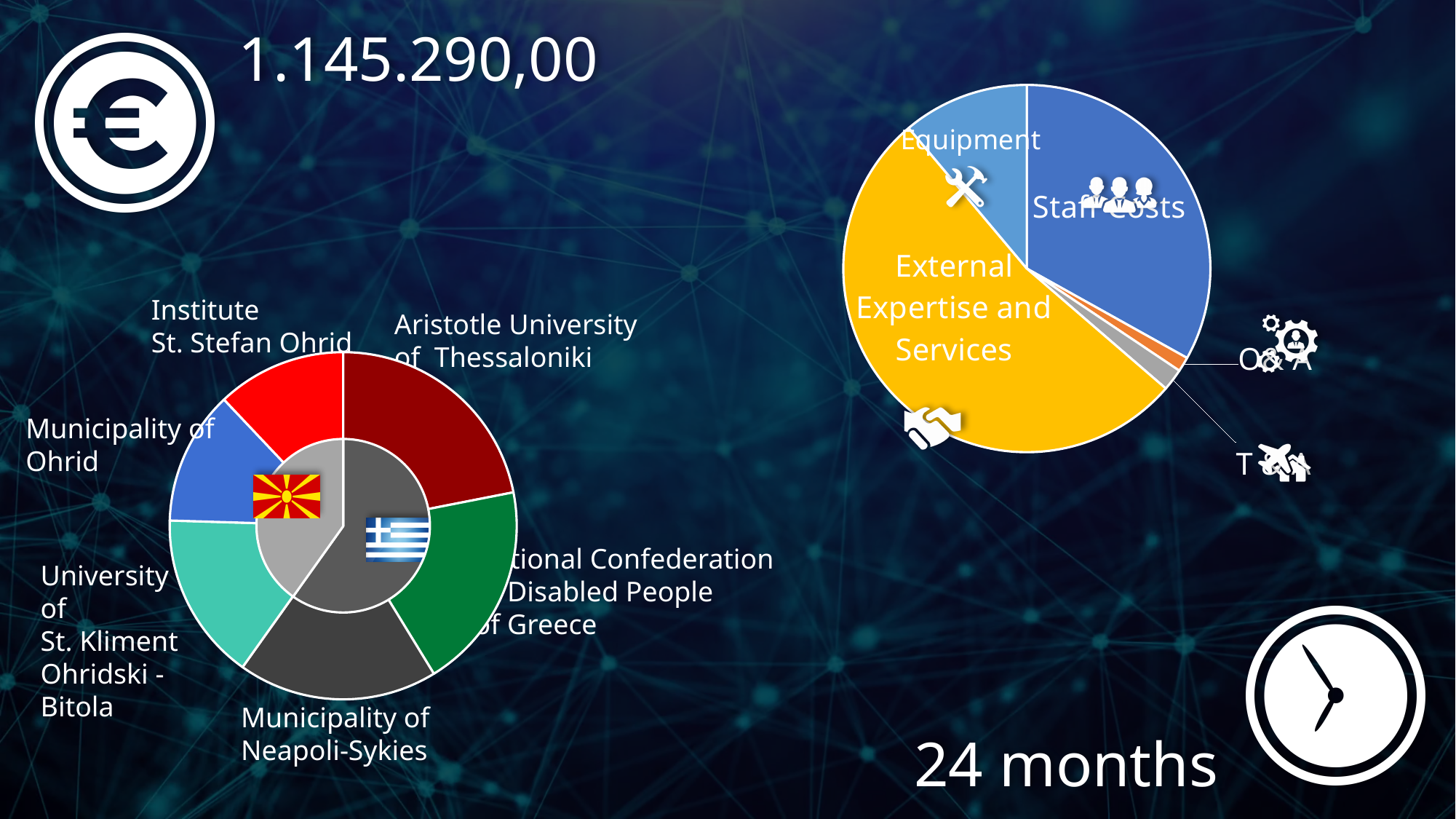
In the doughnut chart on the left, what colour is the Municipality of Ohrid segment? blue What kind of chart is the chart on the left of the slide showing the project partners? doughnut chart In the doughnut chart on the left, which outer-ring segment is larger, Aristotle University of Thessaloniki or Municipality of Ohrid? Aristotle University of Thessaloniki How many slices does the pie chart on the right have? 5 In the pie chart on the right, which slice is larger, External Expertise and Services or Staff Costs? External Expertise and Services In the pie chart on the right, which slice is larger, Staff Costs or Equipment? Staff Costs In the pie chart on the right, which category has the largest slice? External Expertise and Services What kind of chart is the chart on the right of the slide? pie chart In the doughnut chart on the left, which partner has the largest segment in the outer ring? Aristotle University of Thessaloniki How many partner segments are in the outer ring of the doughnut chart on the left? 6 In the pie chart on the right, what colour is the External Expertise and Services slice? yellow